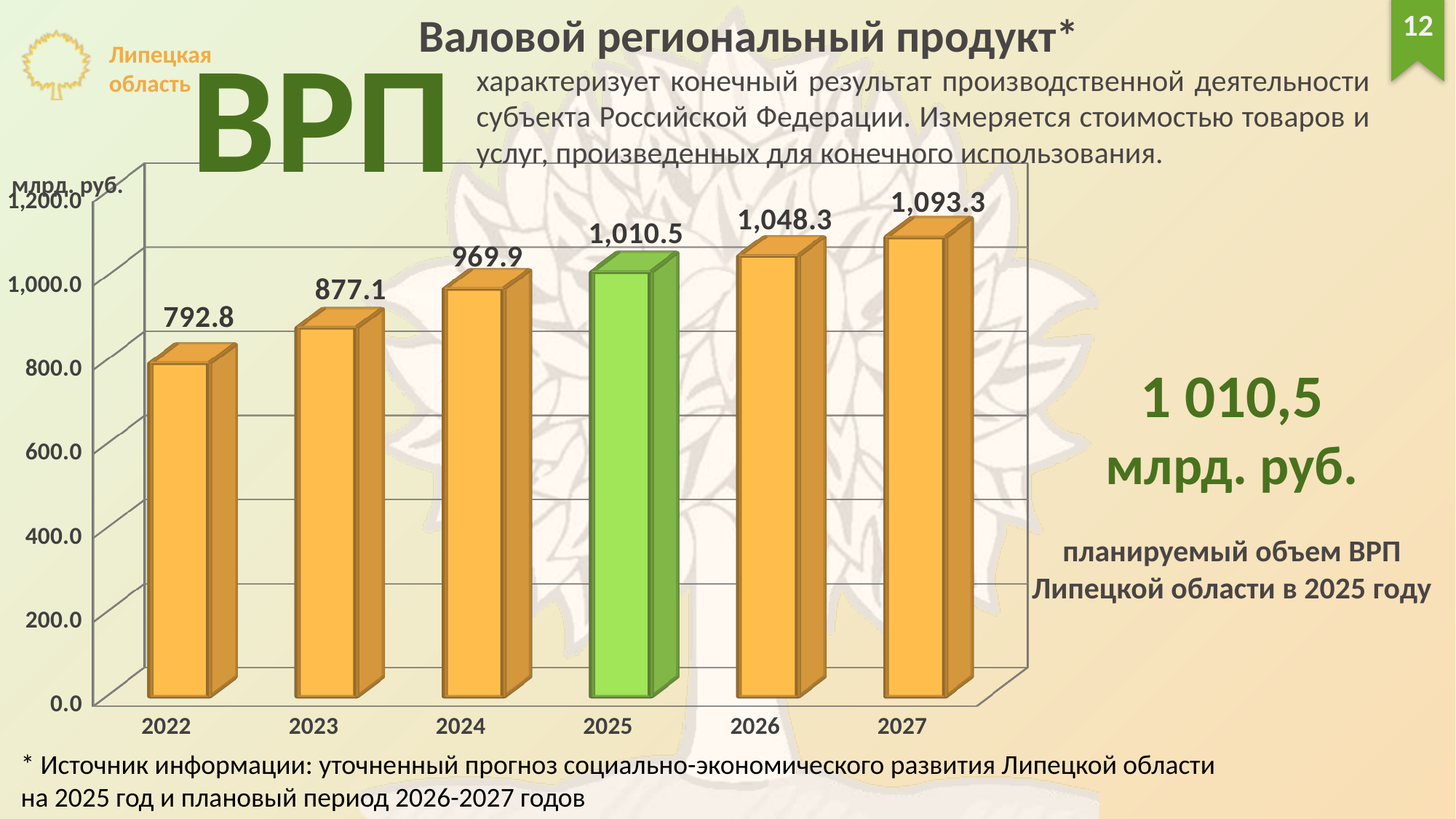
What is the value for 2027? 1,093.3 What is the value for 2025? 1,010.5 What is the value for 2022? 792.8 Do the values rise or fall from 2022 to 2027? rise Which year has the lowest value? 2022 Is the value for 2024 greater or less than 1,000.0? less What is the difference between the values for 2027 and 2022? 300.5 Which year has the highest value? 2027 What kind of chart is shown on the slide? bar chart How many years are shown on the x axis? 6 What is the difference between the values for 2023 and 2022? 84.3 Which is larger, the value for 2024 or the value for 2026? 2026